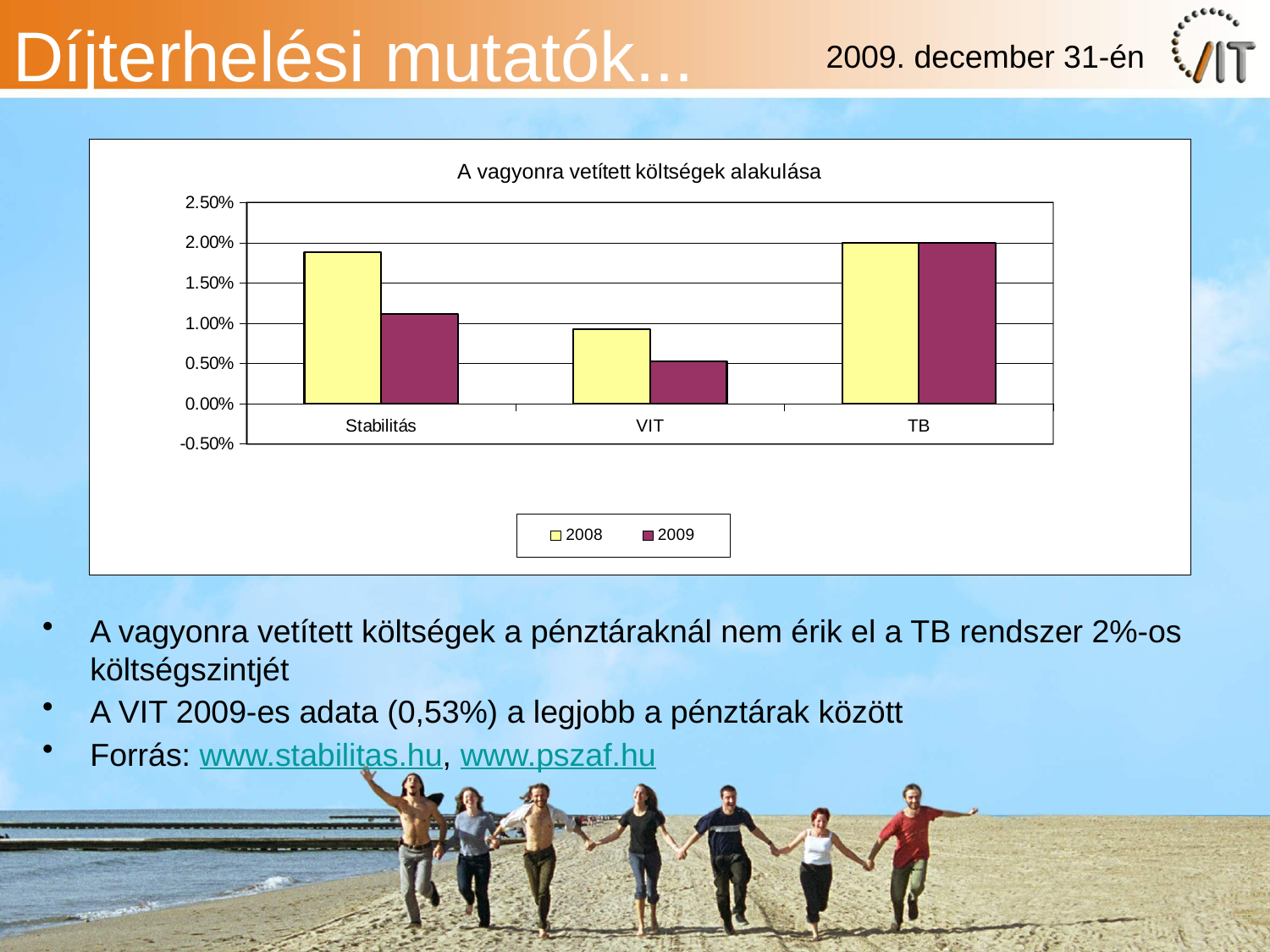
Which series is shown in yellow in the chart? 2008 Is the 2008 value for Stabilitás greater or less than 1.50%? greater What kind of chart is shown on the slide? bar chart What is the title of the chart? A vagyonra vetített költségek alakulása Which category has the highest value for 2008? TB For Stabilitás, which is larger: the 2008 value or the 2009 value? 2008 How many categories are shown on the x axis of the chart? 3 How many series does the chart's legend list? 2 Which category has the lowest value for 2008? VIT Is the 2009 value for Stabilitás greater or less than 1.00%? greater Is the 2008 value for VIT greater or less than 1.00%? less Which category has the lowest value for 2009? VIT